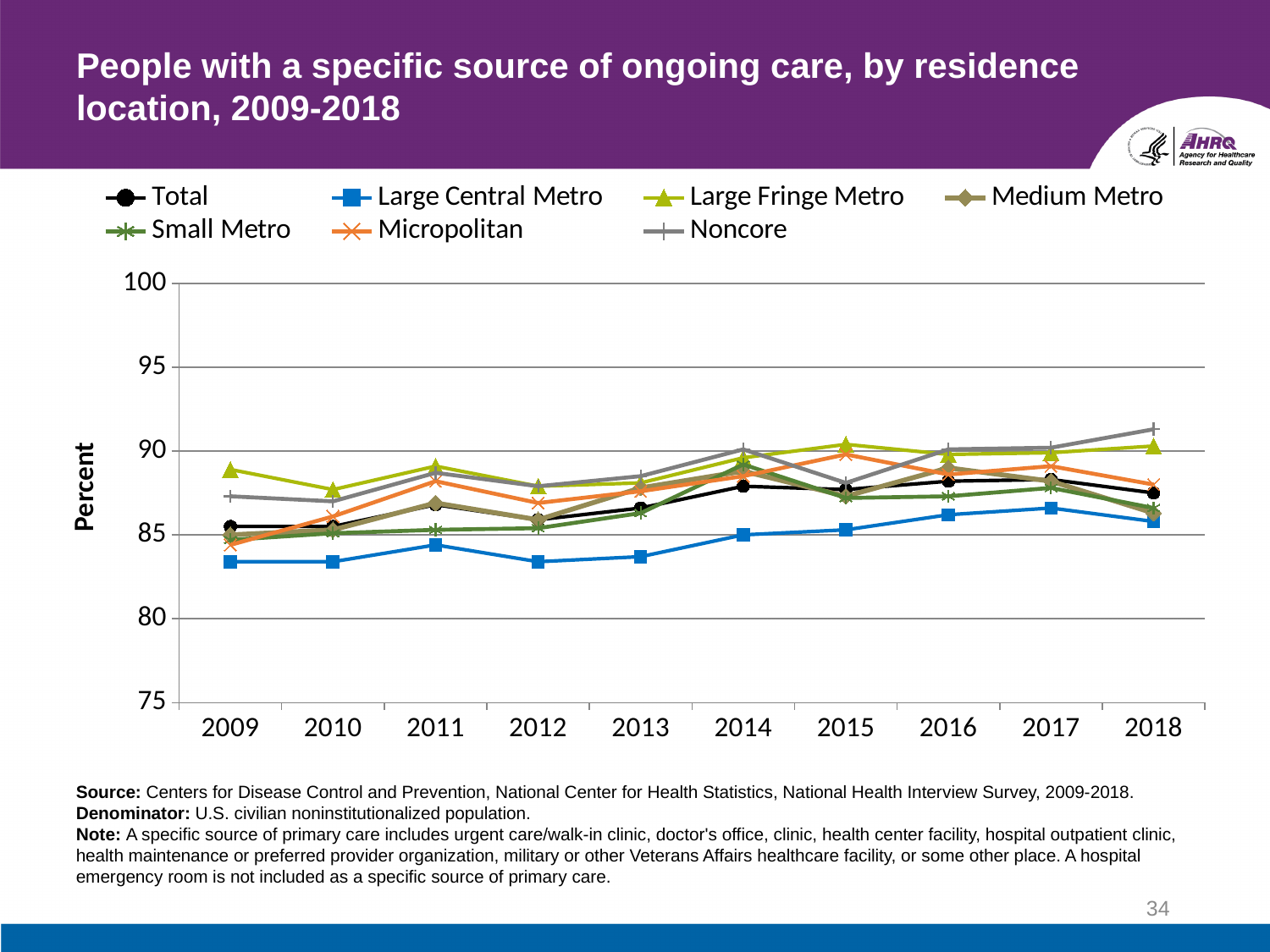
Which residence location has the lowest value in 2018? Large Central Metro How many series does the legend list? 7 Does the Large Central Metro line rise or fall overall from 2009 to 2018? Rise What is the label on the vertical axis? Percent Is the value for Noncore in 2018 greater or less than 90? greater In 2009, which is larger: Large Fringe Metro or Large Central Metro? Large Fringe Metro Which residence location has the lowest value in 2009? Large Central Metro Is the value for Large Central Metro in 2009 greater or less than 85? less How many years are plotted along the x axis? 10 Which residence location has the highest value in 2018? Noncore What kind of chart is shown on the slide? Line chart Is the value for Large Fringe Metro in 2009 greater or less than 85? greater